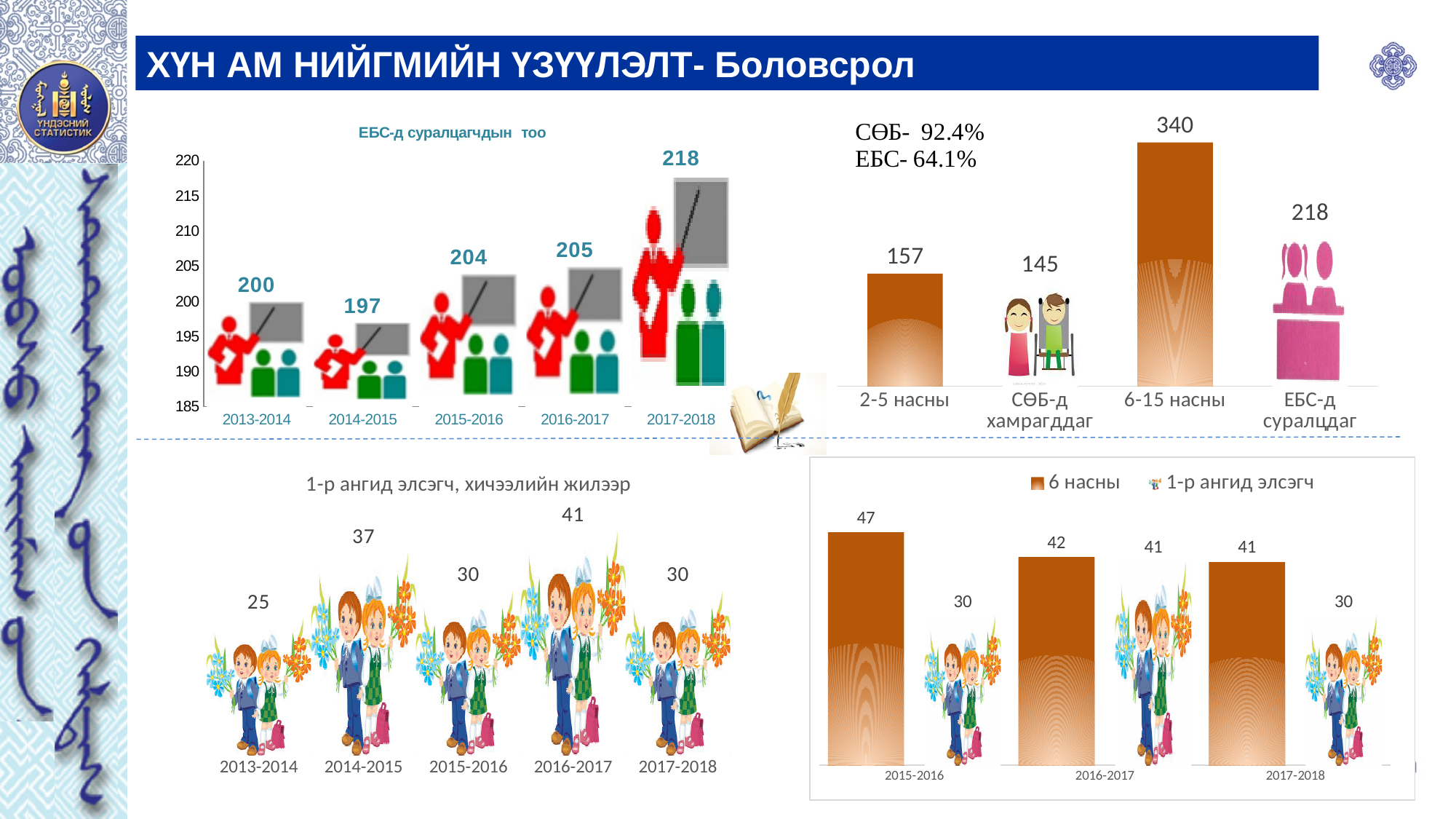
In the chart titled 'ЕБС-д суралцагчдын тоо', what is the value for 2017-2018? 218 In the chart titled 'ЕБС-д суралцагчдын тоо', what is the difference between the values for 2017-2018 and 2013-2014? 18 In the bottom-right chart, what is the value of '6 насны' for 2015-2016? 47 In the top-right chart, which category has the lowest value? СӨБ-д хамрагддаг In the chart titled 'ЕБС-д суралцагчдын тоо', how many school years are shown on the x axis? 5 In the bottom-right chart, which is larger for 2016-2017: '6 насны' or '1-р ангид элсэгч'? 6 насны In the chart titled 'ЕБС-д суралцагчдын тоо', which school year has the lowest value? 2014-2015 In the top-right chart, what is the value for '6-15 насны'? 340 In the bottom-right chart, how many series does the legend list? 2 In the chart titled '1-р ангид элсэгч, хичээлийн жилээр', what is the value for 2014-2015? 37 In the top-right chart, what is the difference between the values for '2-5 насны' and 'СӨБ-д хамрагддаг'? 12 In the chart titled '1-р ангид элсэгч, хичээлийн жилээр', which school year has the highest value? 2016-2017